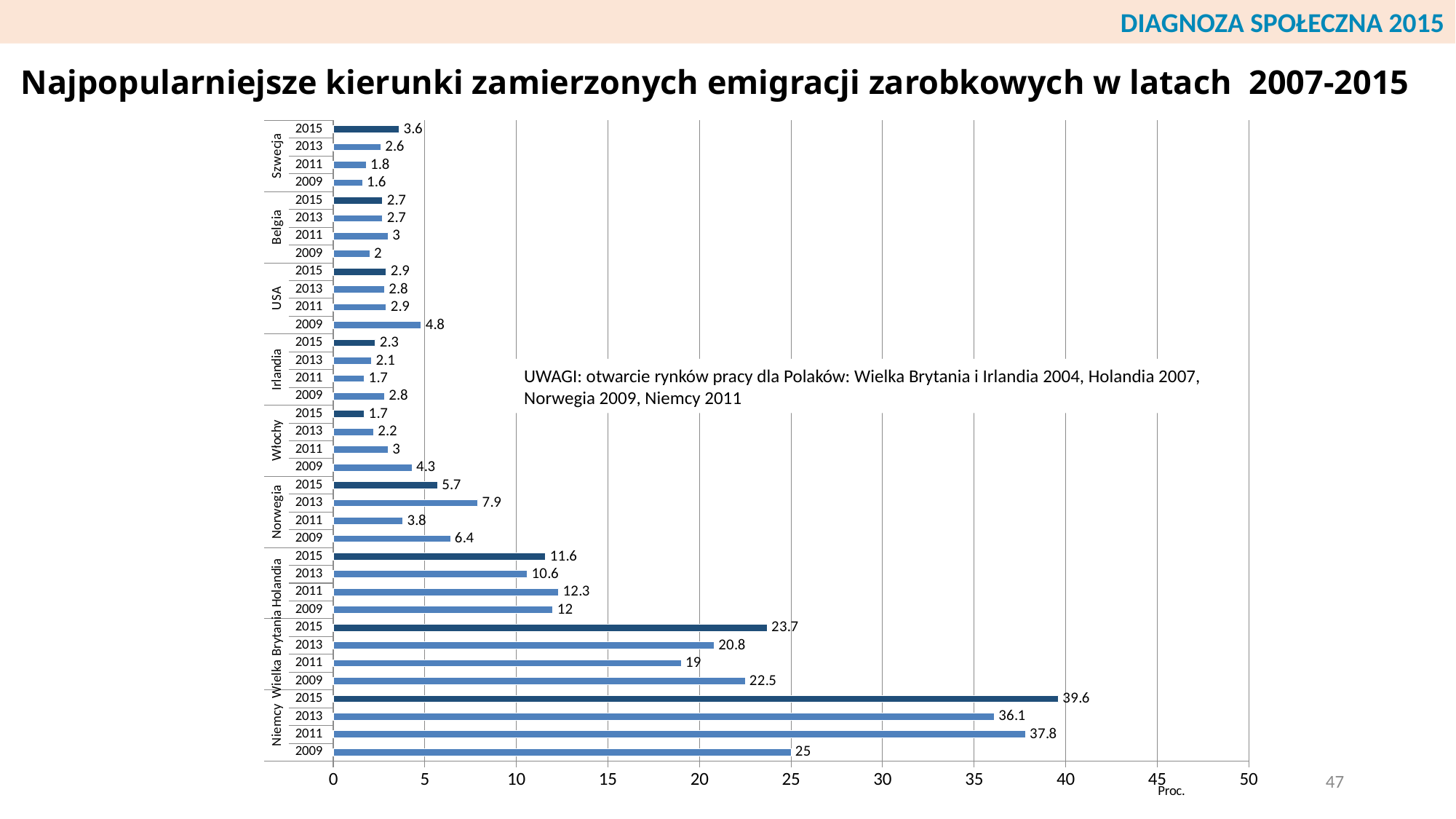
What unit label is shown at the end of the horizontal axis? Proc. How many countries are shown on the chart? 9 What kind of chart is shown on the slide? bar chart Which bar has the highest value on the chart? Niemcy 2015 Which is larger, the Holandia value for 2011 or for 2013? 2011 What is the value for Szwecja in 2009? 1.6 Which year has the lowest value for Włochy? 2015 Is the value for Wielka Brytania in 2015 greater or less than 20? greater What is the value for Niemcy in 2015? 39.6 What is the value for Wielka Brytania in 2011? 19 What is the value for Norwegia in 2013? 7.9 What is the difference between the Niemcy values for 2015 and 2009? 14.6